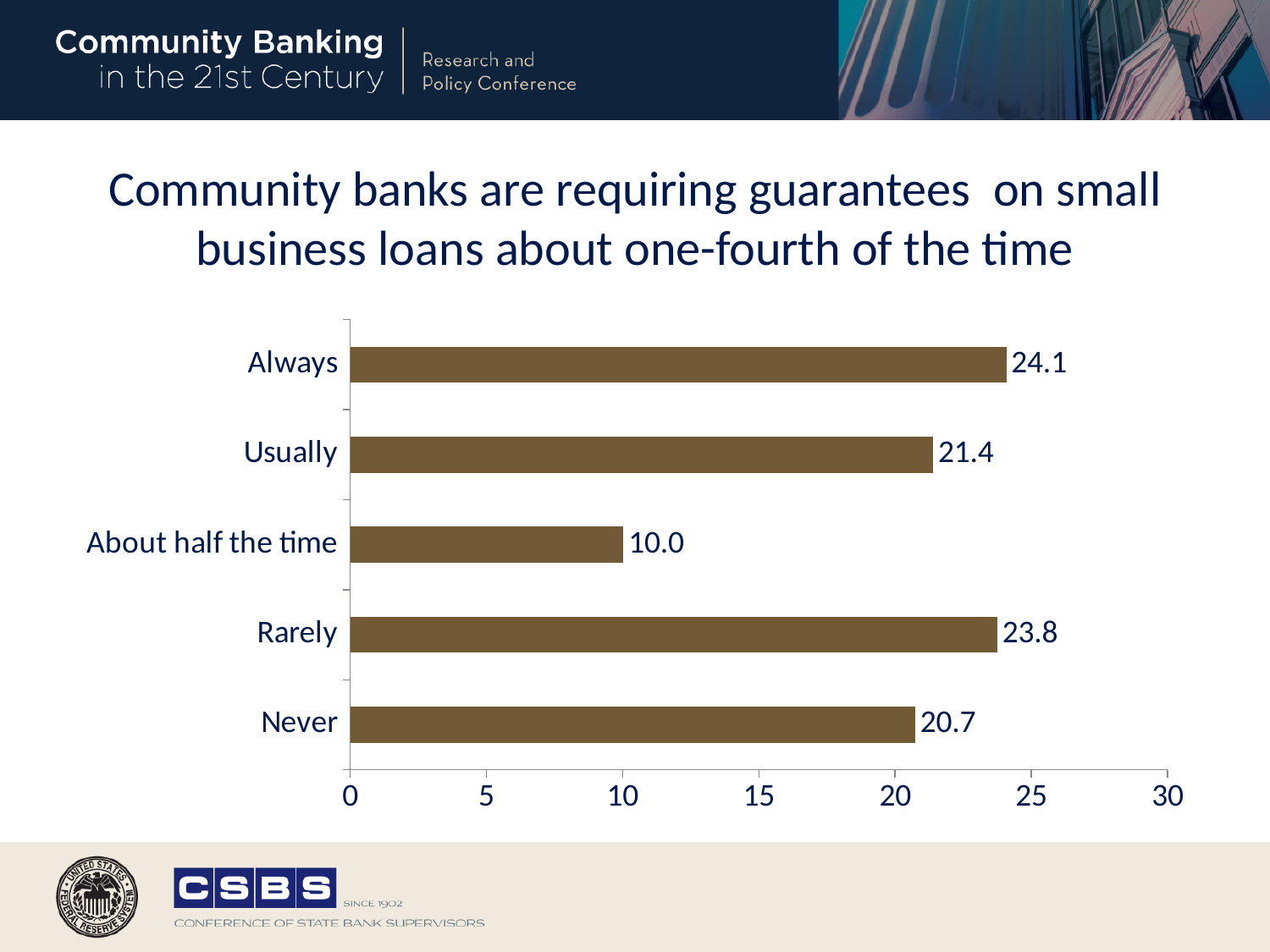
Which category has the lowest value? About half the time What is the difference between the values for "Always" and "About half the time"? 14.1 Which category has the highest value? Always What kind of chart is shown on the slide? Bar chart Which is larger, the value for "Usually" or the value for "Never"? Usually Is the value for "Rarely" greater or less than 20? greater What is the value for "Never"? 20.7 What is the value for "About half the time"? 10.0 How many categories are shown in the chart? 5 What is the difference between the values for "Rarely" and "Never"? 3.1 What is the value for "Always"? 24.1 What is the highest value shown on the x axis? 30